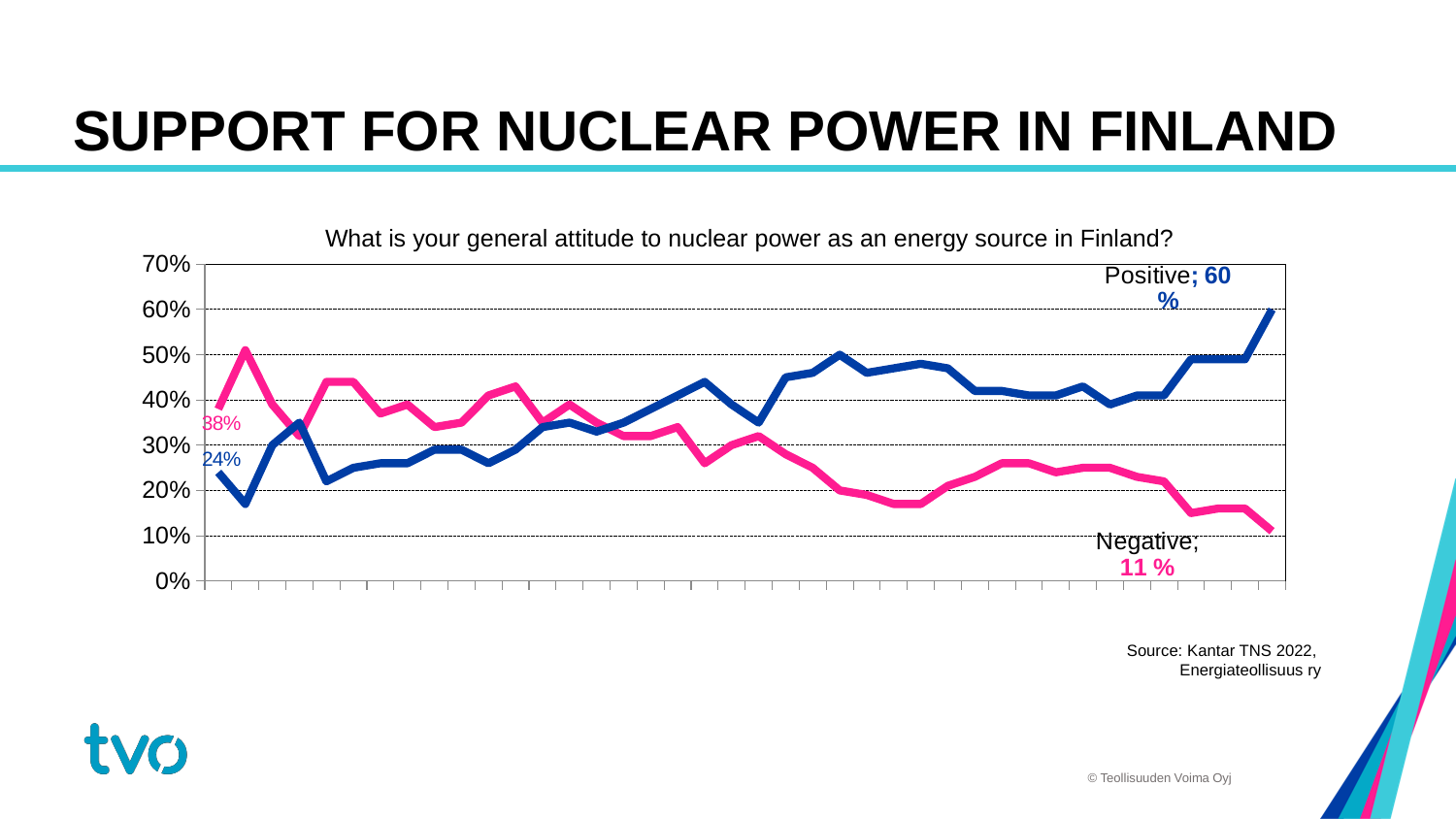
What is the latest value shown for the Positive series? 60 % Does the Positive line generally rise or fall from left to right across the chart? rise At the left end of the chart, which series has the higher value, Positive or Negative? Negative What is the first value labelled for the Negative (pink) line at the left of the chart? 38% At the right end of the chart, which series has the higher value, Positive or Negative? Positive What is the first value labelled for the Positive (blue) line at the left of the chart? 24% What type of chart is shown on the slide? line chart How many data series (lines) are plotted on the chart? 2 What is the difference between the latest Positive value (60 %) and the latest Negative value (11 %)? 49 percentage points What is the difference between the first labelled Negative value (38%) and the first labelled Positive value (24%)? 14 percentage points What is the latest value shown for the Negative series? 11 % What question is shown as the title of the chart? What is your general attitude to nuclear power as an energy source in Finland?